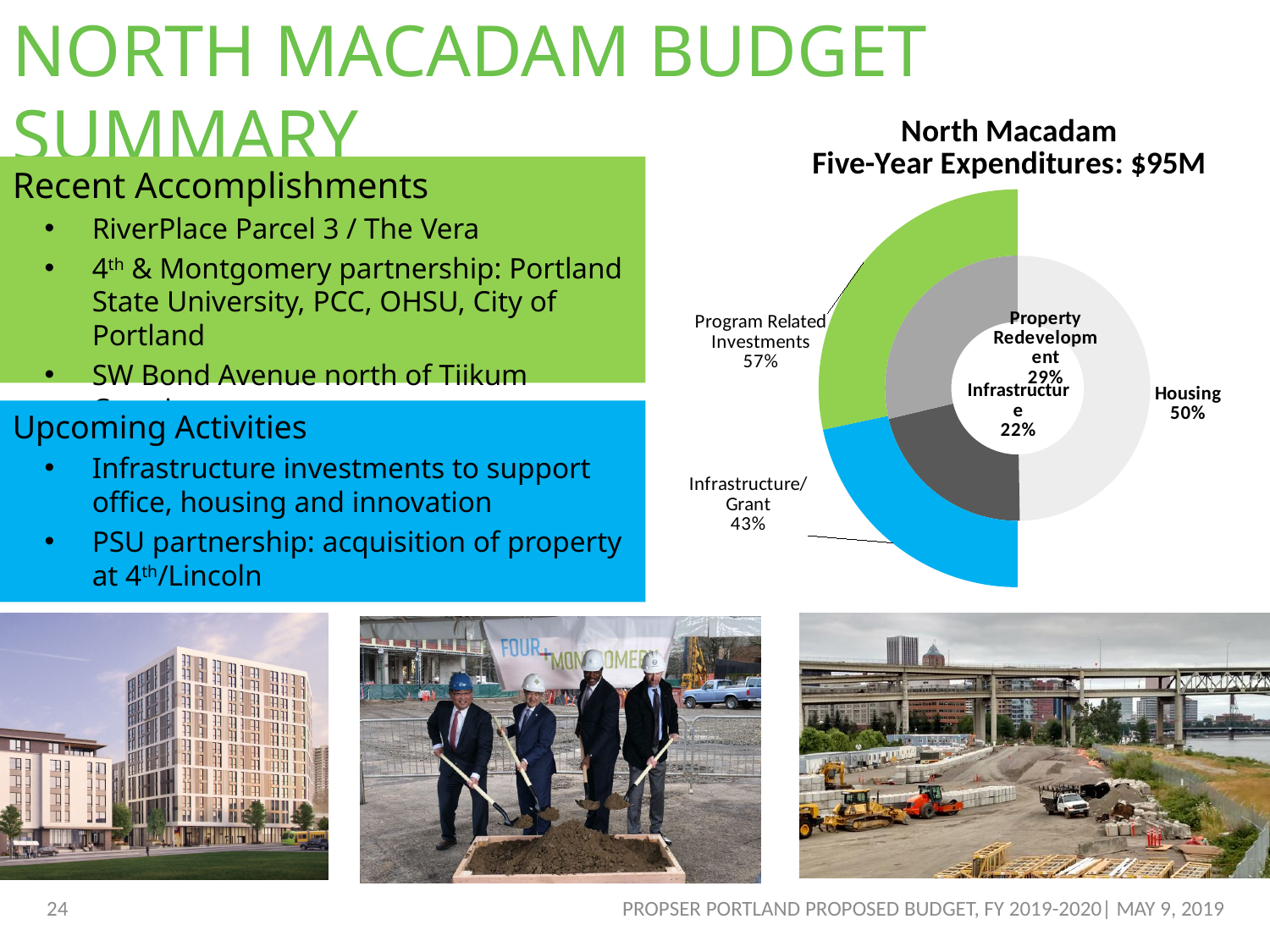
What is the title of the chart? North Macadam Five-Year Expenditures: $95M What share of the inner ring is Housing? 50% How many categories are labeled in the inner ring of the chart? 3 What share of the inner ring is Infrastructure? 22% Which category in the inner ring has the smallest share? Infrastructure What share of the outer ring is Program Related Investments? 57% Which is larger in the outer ring, Program Related Investments or Infrastructure/Grant? Program Related Investments What share of the inner ring is Property Redevelopment? 29% Which category in the inner ring has the largest share? Housing What share of the outer ring is Infrastructure/Grant? 43% What is the difference between the Program Related Investments share and the Infrastructure/Grant share? 14% What kind of chart is shown on the slide? Doughnut chart